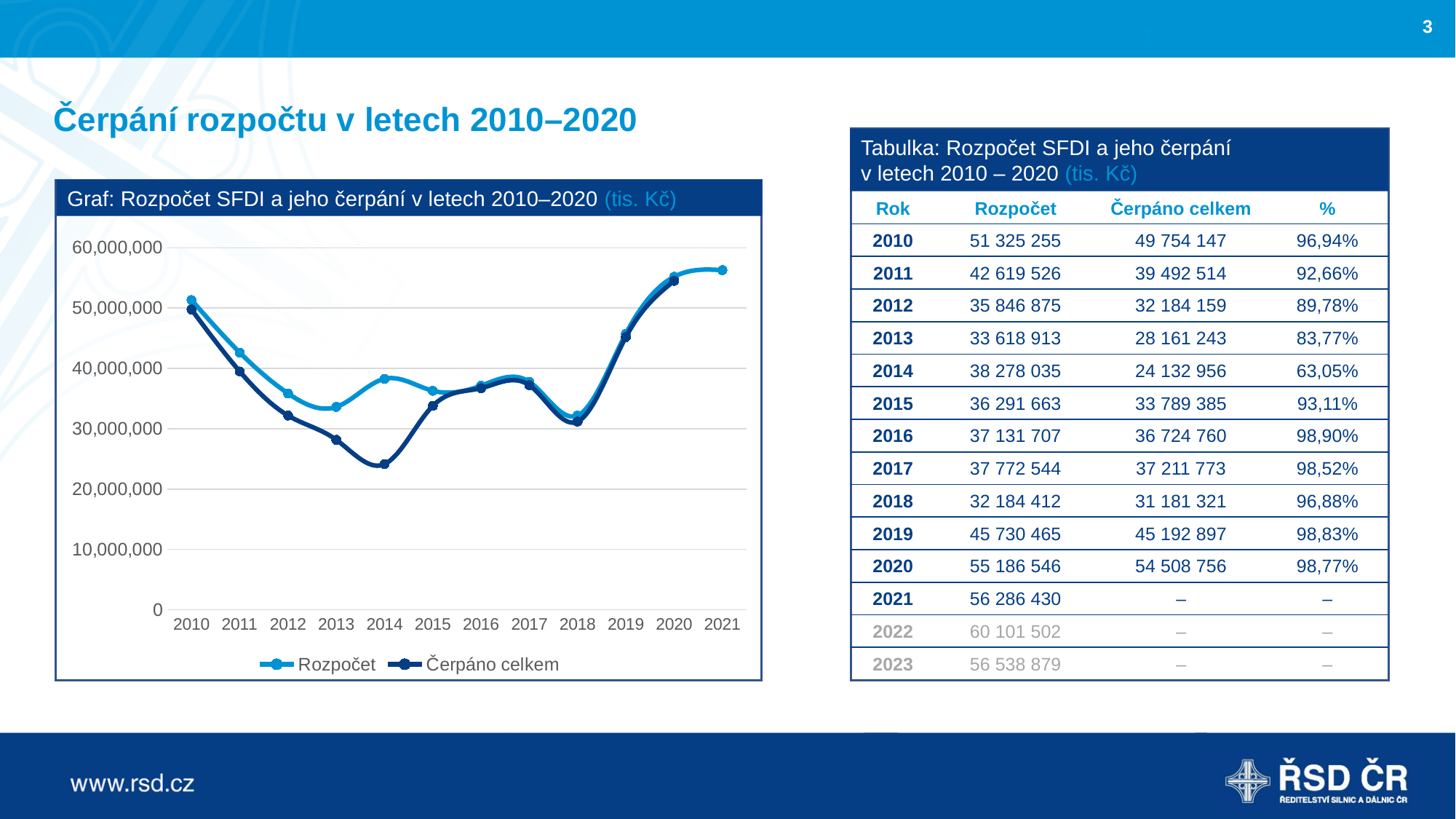
Is the value for Čerpáno celkem in 2014 greater or less than 30,000,000? less How many years are plotted along the x axis of the chart? 12 Does the Čerpáno celkem line rise or fall from 2018 to 2020? rise In which year does the Rozpočet line reach its highest point? 2021 In 2014, which series has the larger value, Rozpočet or Čerpáno celkem? Rozpočet How many series does the chart legend list? 2 Is the value for Rozpočet in 2020 greater or less than 50,000,000? greater Does the Rozpočet line rise or fall from 2010 to 2014? fall What is the difference between Rozpočet and Čerpáno celkem in 2014 (tis. Kč), using the values printed on the slide? 14 145 079 What is the Rozpočet value for 2020 (tis. Kč), as printed on the slide? 55 186 546 In which year does the Čerpáno celkem line reach its lowest point? 2014 What kind of chart is shown on the slide? line chart